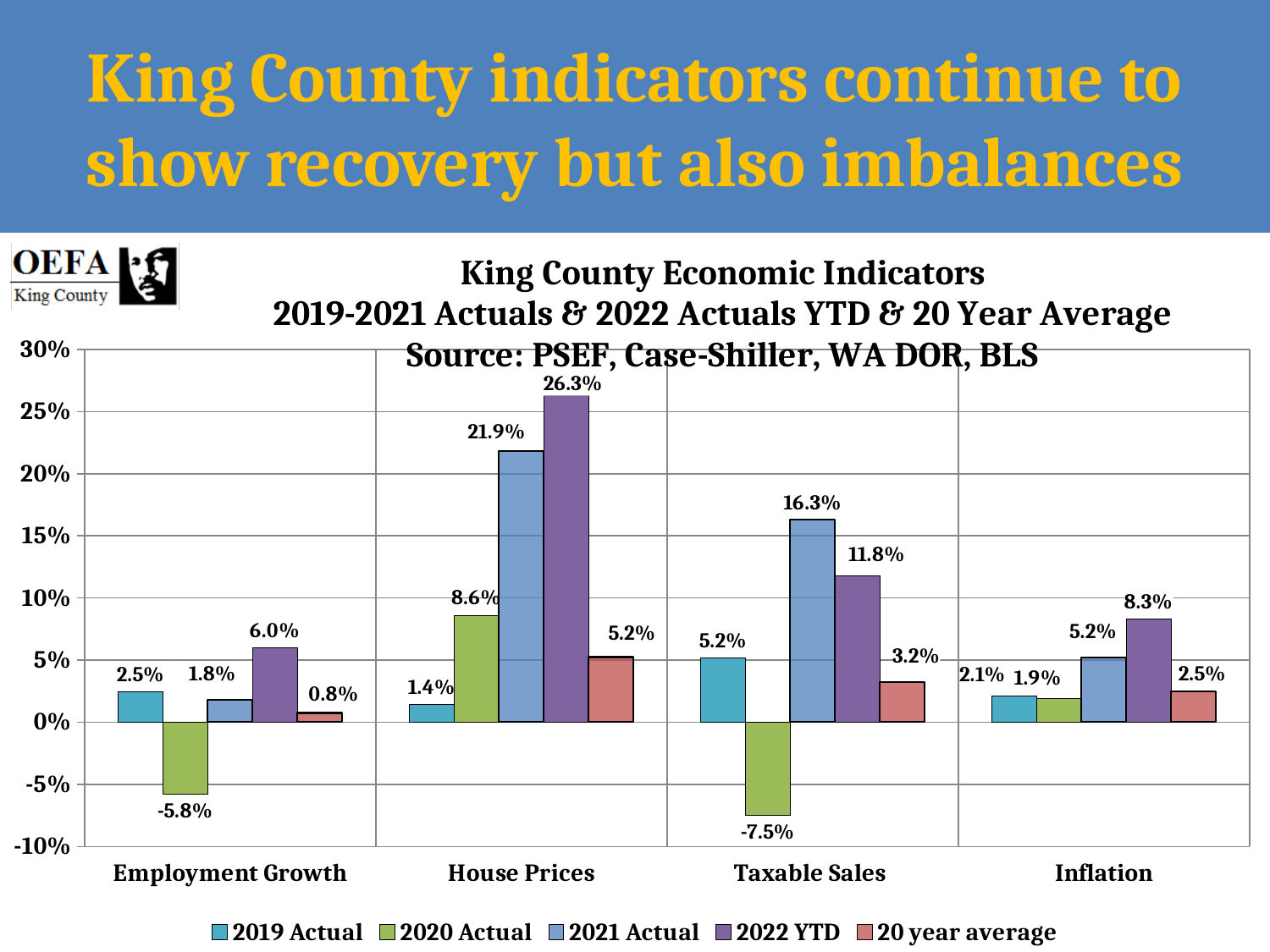
What is the 2020 Actual value for Taxable Sales? -7.5% What kind of chart is shown on the slide? Bar chart How many series does the legend list? 5 Which is larger for Inflation: the 2021 Actual value or the 2022 YTD value? 2022 YTD Which category has the highest 2022 YTD value? House Prices Which category has the lowest 2020 Actual value? Taxable Sales What is the 2022 YTD value for House Prices? 26.3% What is the title of the chart? King County Economic Indicators 2019-2021 Actuals & 2022 Actuals YTD & 20 Year Average Source: PSEF, Case-Shiller, WA DOR, BLS What is the 20 year average value for Inflation? 2.5% How many categories are shown on the x axis? 4 What is the 2021 Actual value for Employment Growth? 1.8% What is the difference between the 2021 Actual and 2022 YTD values for Taxable Sales? 4.5%